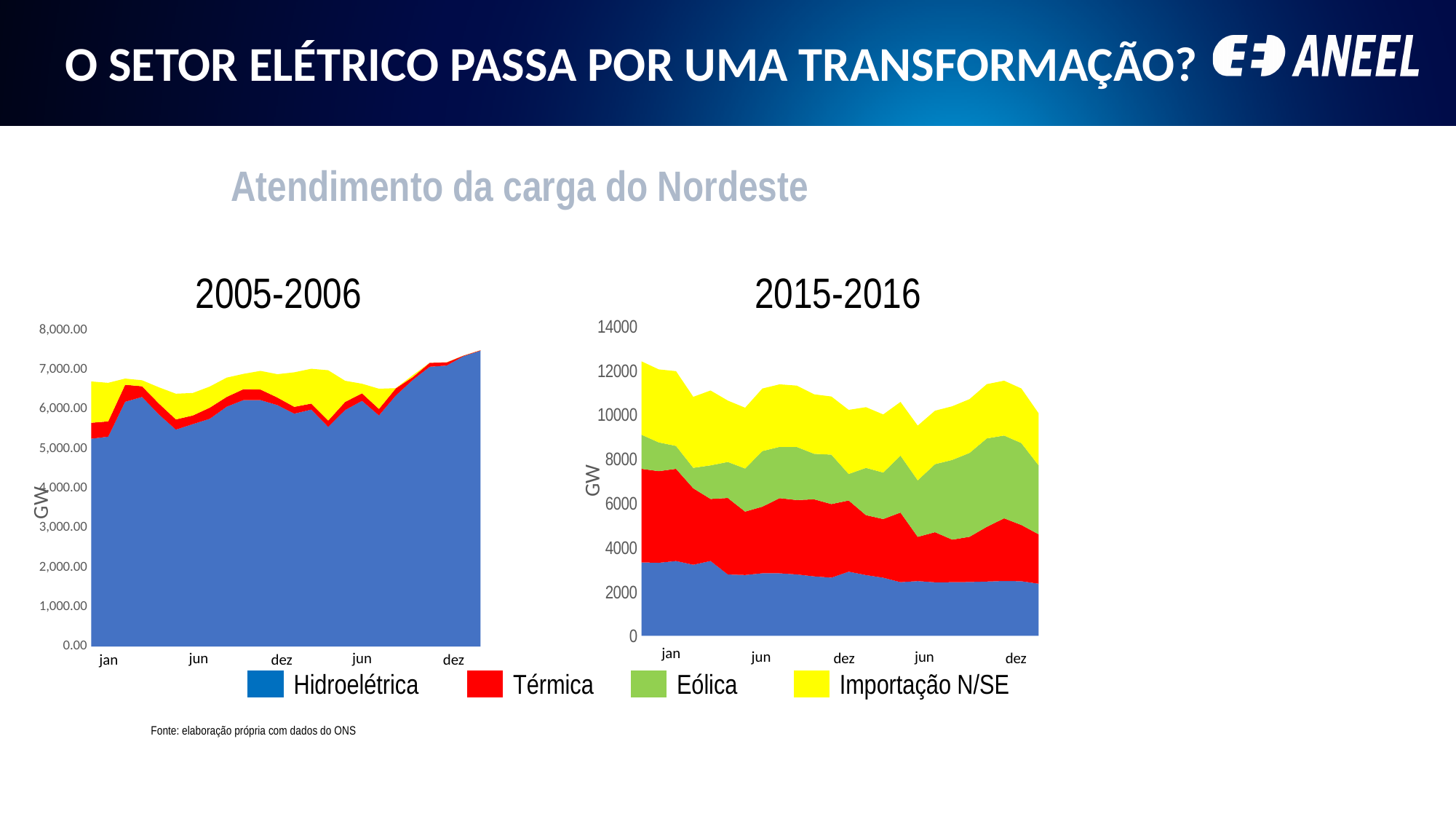
In the 2015-2016 chart, is the Hidroelétrica value at the last dez greater or less than 3000? less In the 2015-2016 chart, is the total stacked value at the first jan greater or less than 10000? greater In the 2015-2016 chart, is the Hidroelétrica value larger at the first jan or at the last dez? first jan In the 2015-2016 chart, does the Hidroelétrica series rise or fall from the first jan to the last dez? fall In the 2005-2006 chart, is the Hidroelétrica value at the last dez greater or less than 7,000.00? greater What is the title shown above the two charts? Atendimento da carga do Nordeste What unit is shown on the y axis of the 2015-2016 chart? GW In the 2005-2006 chart, does the Hidroelétrica series rise or fall from the first jan to the last dez? rise What kind of chart is the 2005-2006 chart? Stacked area chart How many series does the legend list? 4